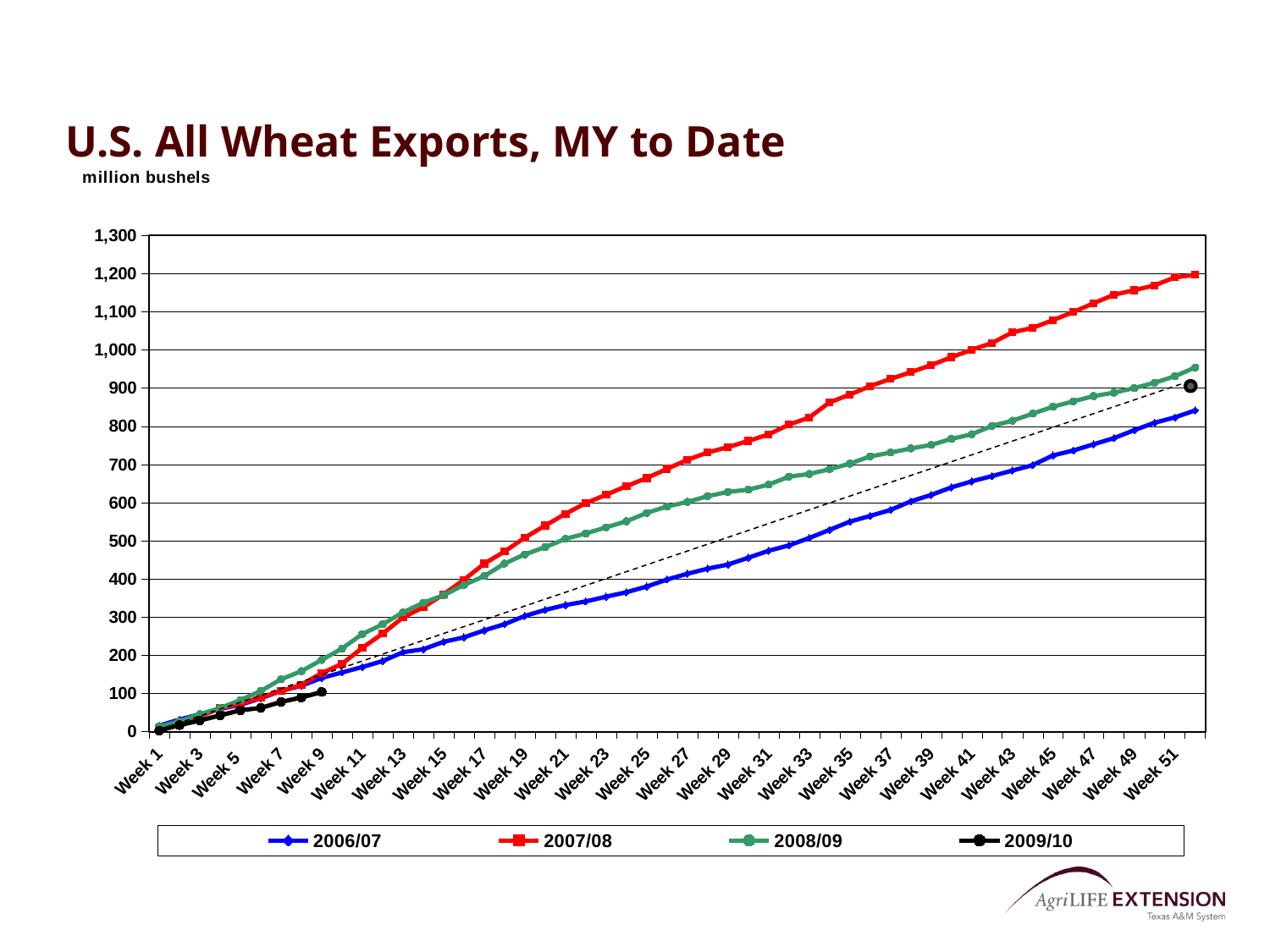
Which series has the highest value at Week 51? 2007/08 How many series does the legend list? 4 At Week 31, which series has the larger value, 2008/09 or 2006/07? 2008/09 Which series has the lowest value at Week 51 among those plotted through Week 51? 2006/07 Do the values for the 2007/08 series rise or fall from Week 1 to Week 51? rise At Week 41, which series has the larger value, 2007/08 or 2008/09? 2007/08 What unit is the chart measured in? million bushels Is the value for 2009/10 at Week 9 greater or less than 200? less What kind of chart is shown on the slide? line chart Is the value for 2007/08 at Week 51 greater or less than 1,100? greater Is the value for 2006/07 at Week 51 greater or less than 700? greater What is the title of the chart? U.S. All Wheat Exports, MY to Date